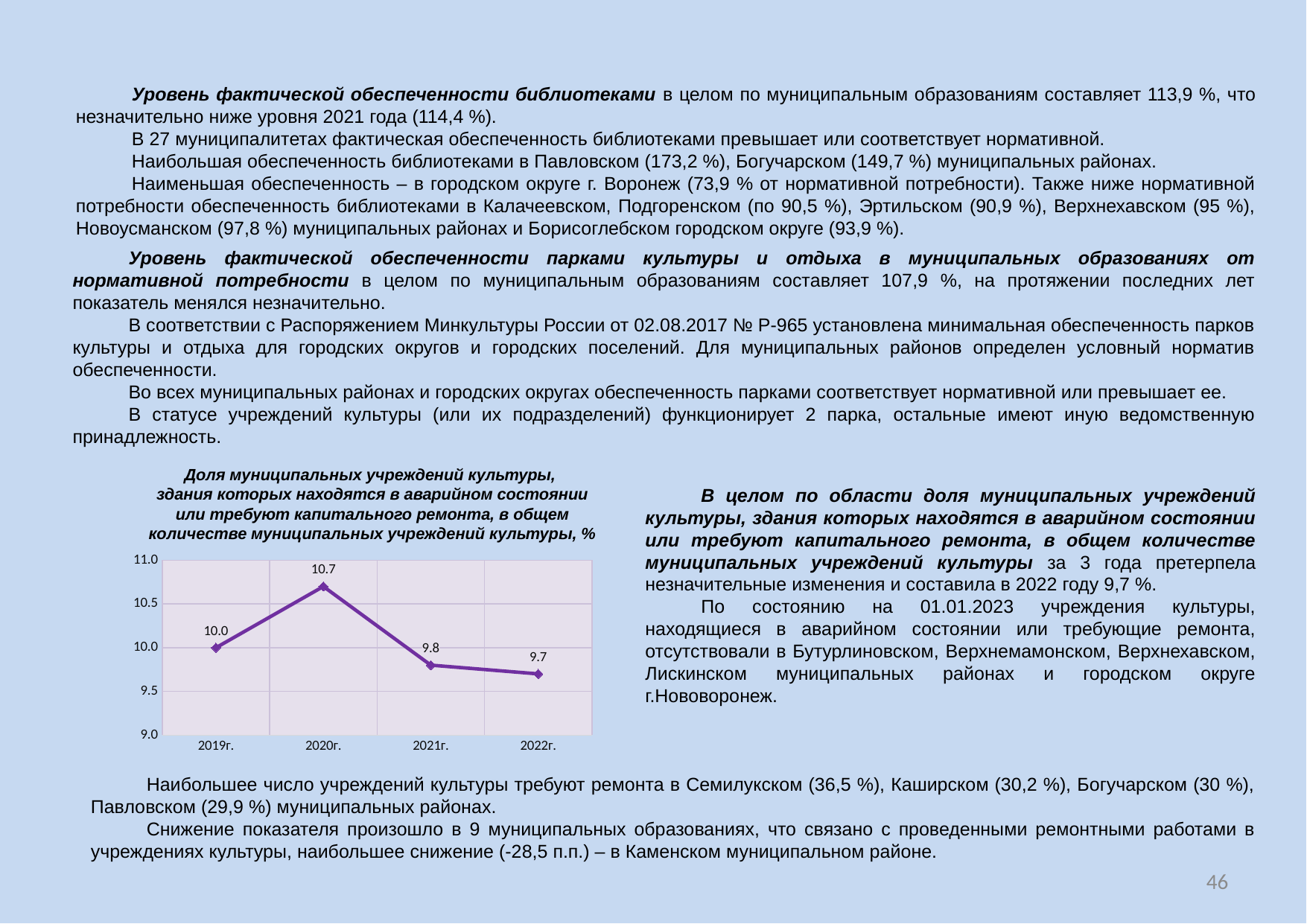
What type of chart is shown on the slide? line chart What is the difference between the values for 2020г. and 2022г.? 1.0 What is the value for 2019г. in the chart? 10.0 Which year has the highest value in the chart? 2020г. What unit is indicated at the end of the chart title? % What is the value for 2022г. in the chart? 9.7 Does the value rise or fall from 2020г. to 2022г.? fall What is the value for 2021г. in the chart? 9.8 What is the value for 2020г. in the chart? 10.7 How many data points are plotted in the chart? 4 Which year has the lowest value in the chart? 2022г. Which is larger, the value for 2019г. or the value for 2021г.? 2019г.